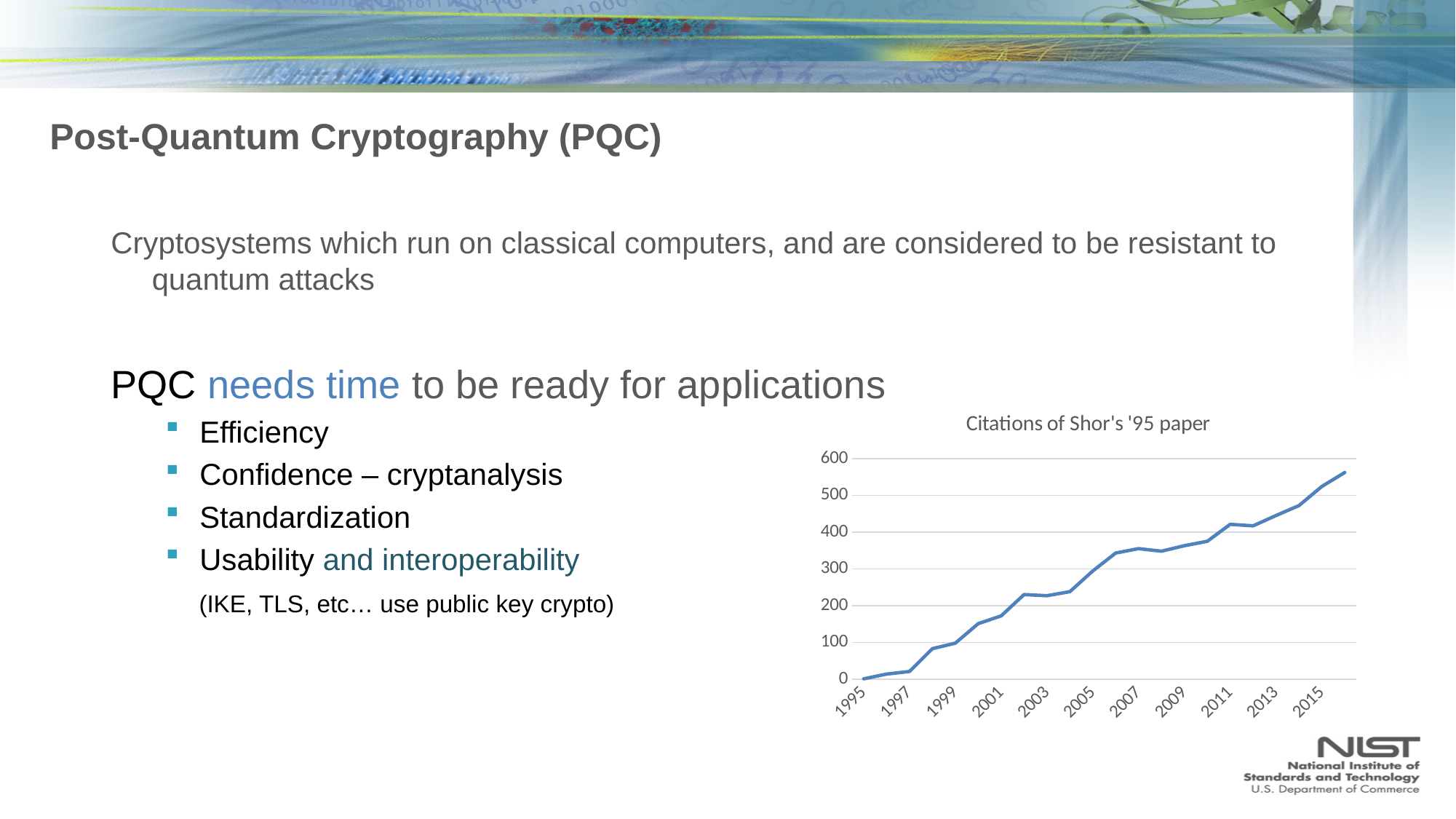
Which year shown on the x axis has the lowest citation count? 1995 Is the value for 2003 greater or less than 200? greater How many year labels are shown on the x axis? 11 Is the value for 2015 greater or less than 500? greater What is the highest value shown on the y axis? 600 Which has the larger value, 2001 or 2009? 2009 What kind of chart is shown on the slide? line chart What is the title of the chart on the slide? Citations of Shor's '95 paper Do the citation counts generally rise or fall from 1995 to 2015? rise Is the value for 2011 greater or less than 400? greater